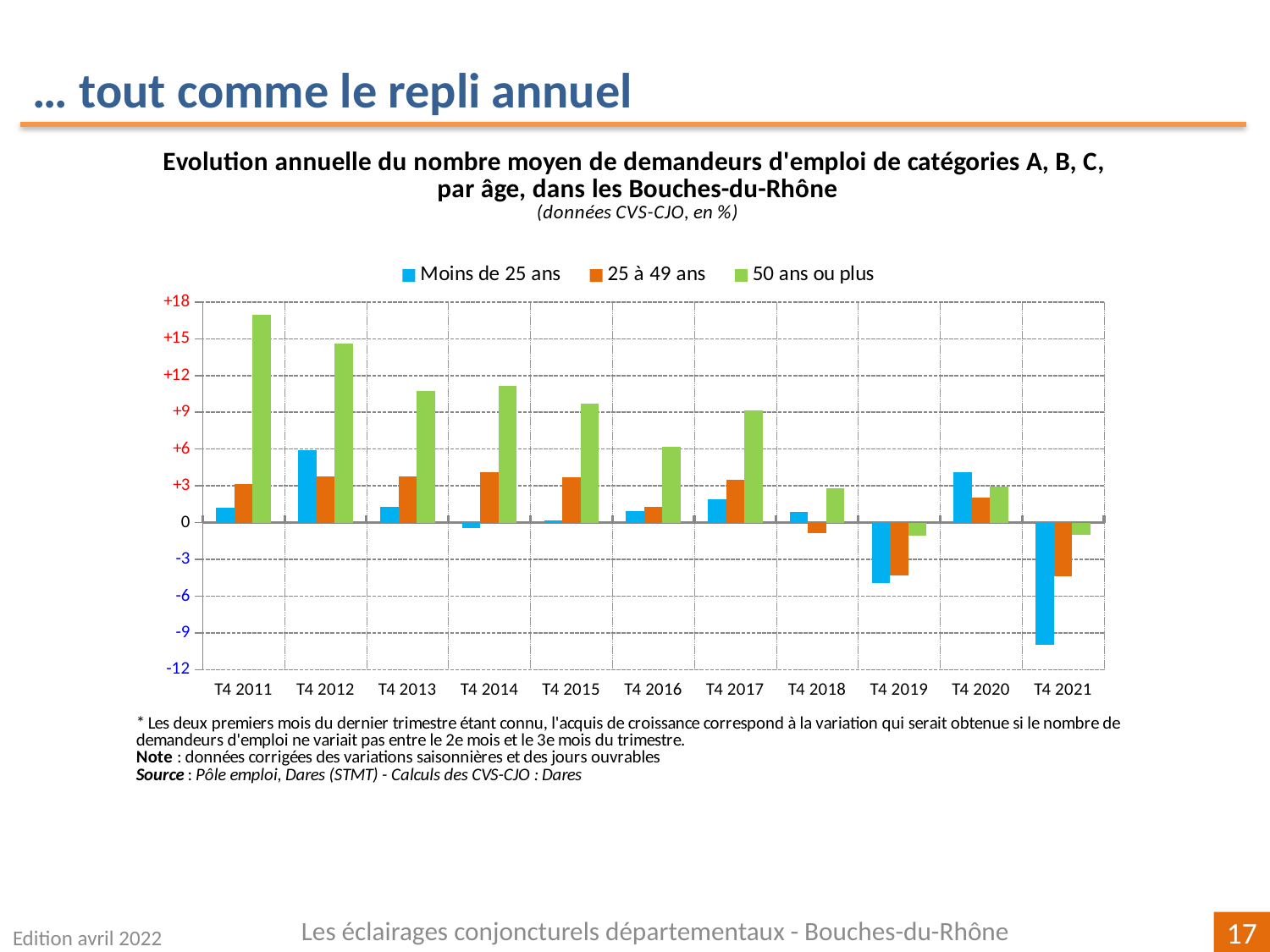
In T4 2020, which is larger: the value for 'Moins de 25 ans' or for '50 ans ou plus'? Moins de 25 ans Which colour represents the '50 ans ou plus' series in the legend? green Overall, does the value for '50 ans ou plus' rise or fall from T4 2011 to T4 2021? fall How many quarters (categories) are shown on the x axis? 11 Is the value for '50 ans ou plus' in T4 2011 greater or less than +15? greater Is the value for '25 à 49 ans' in T4 2014 greater or less than +3? greater Is the value for 'Moins de 25 ans' in T4 2021 greater or less than -6? less In T4 2012, which is larger: the value for 'Moins de 25 ans' or for '25 à 49 ans'? Moins de 25 ans In which quarter is the value for 'Moins de 25 ans' the lowest? T4 2021 What kind of chart is shown on the slide? bar chart In which quarter is the value for '50 ans ou plus' the highest? T4 2011 How many series does the legend list? 3